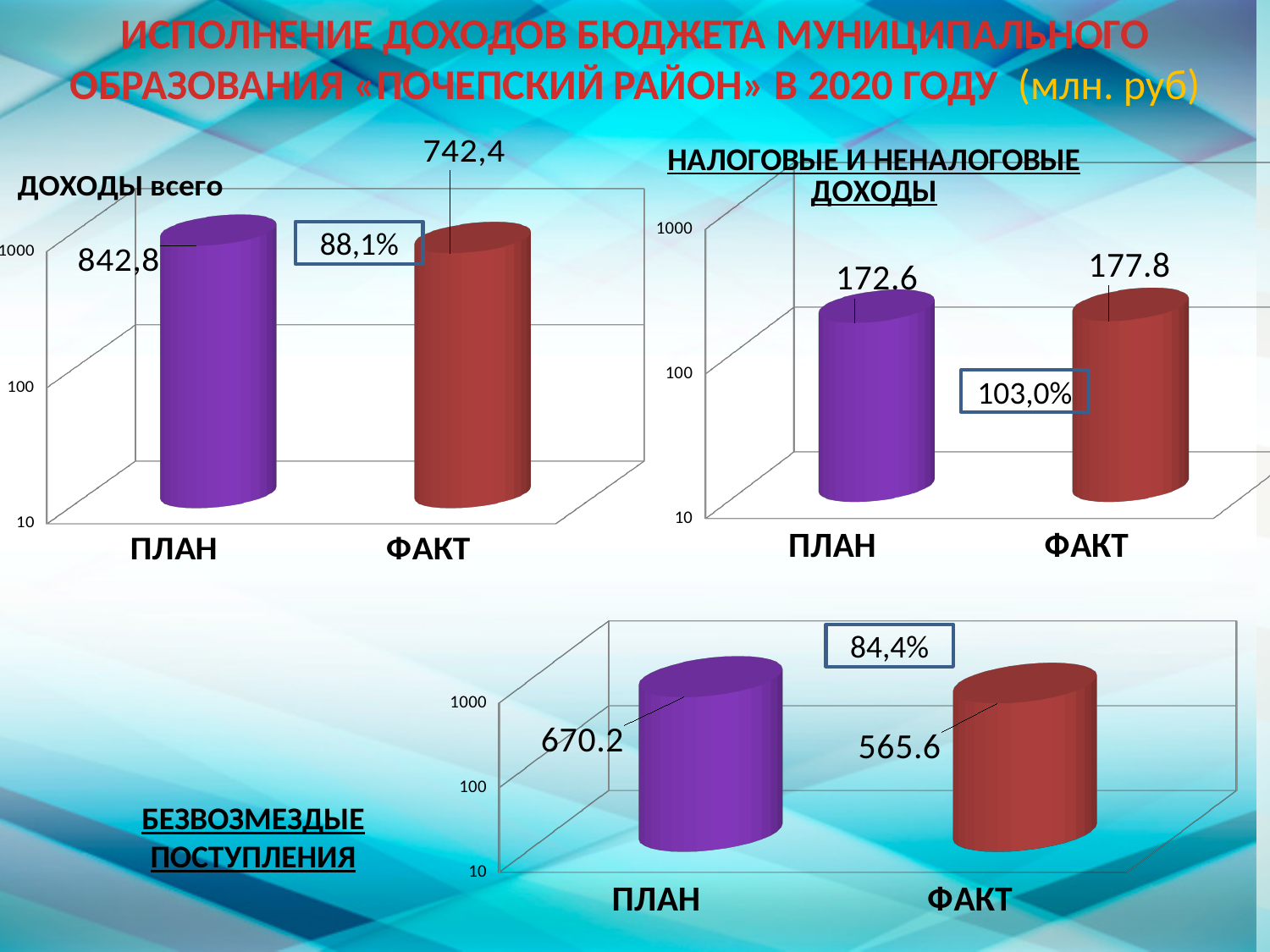
What percentage is shown in the box on the 'НАЛОГОВЫЕ И НЕНАЛОГОВЫЕ ДОХОДЫ' chart? 103,0% In the 'НАЛОГОВЫЕ И НЕНАЛОГОВЫЕ ДОХОДЫ' chart, what is the value for ФАКТ? 177.8 In the 'БЕЗВОЗМЕЗДНЫЕ ПОСТУПЛЕНИЯ' chart, what is the difference between the ПЛАН and ФАКТ values? 104.6 In the 'ДОХОДЫ всего' chart, what is the value for ФАКТ? 742,4 In the 'ДОХОДЫ всего' chart, what is the difference between the ПЛАН and ФАКТ values? 100,4 What kind of chart is the 'БЕЗВОЗМЕЗДНЫЕ ПОСТУПЛЕНИЯ' chart? Bar chart In the 'НАЛОГОВЫЕ И НЕНАЛОГОВЫЕ ДОХОДЫ' chart, which category has the higher value, ПЛАН or ФАКТ? ФАКТ In the 'БЕЗВОЗМЕЗДНЫЕ ПОСТУПЛЕНИЯ' chart, what is the value for ФАКТ? 565.6 In the 'ДОХОДЫ всего' chart, which category has the lowest value? ФАКТ How many categories are shown in the 'НАЛОГОВЫЕ И НЕНАЛОГОВЫЕ ДОХОДЫ' chart? 2 In the 'БЕЗВОЗМЕЗДНЫЕ ПОСТУПЛЕНИЯ' chart, what is the value for ПЛАН? 670.2 In the 'ДОХОДЫ всего' chart, what is the value for ПЛАН? 842,8